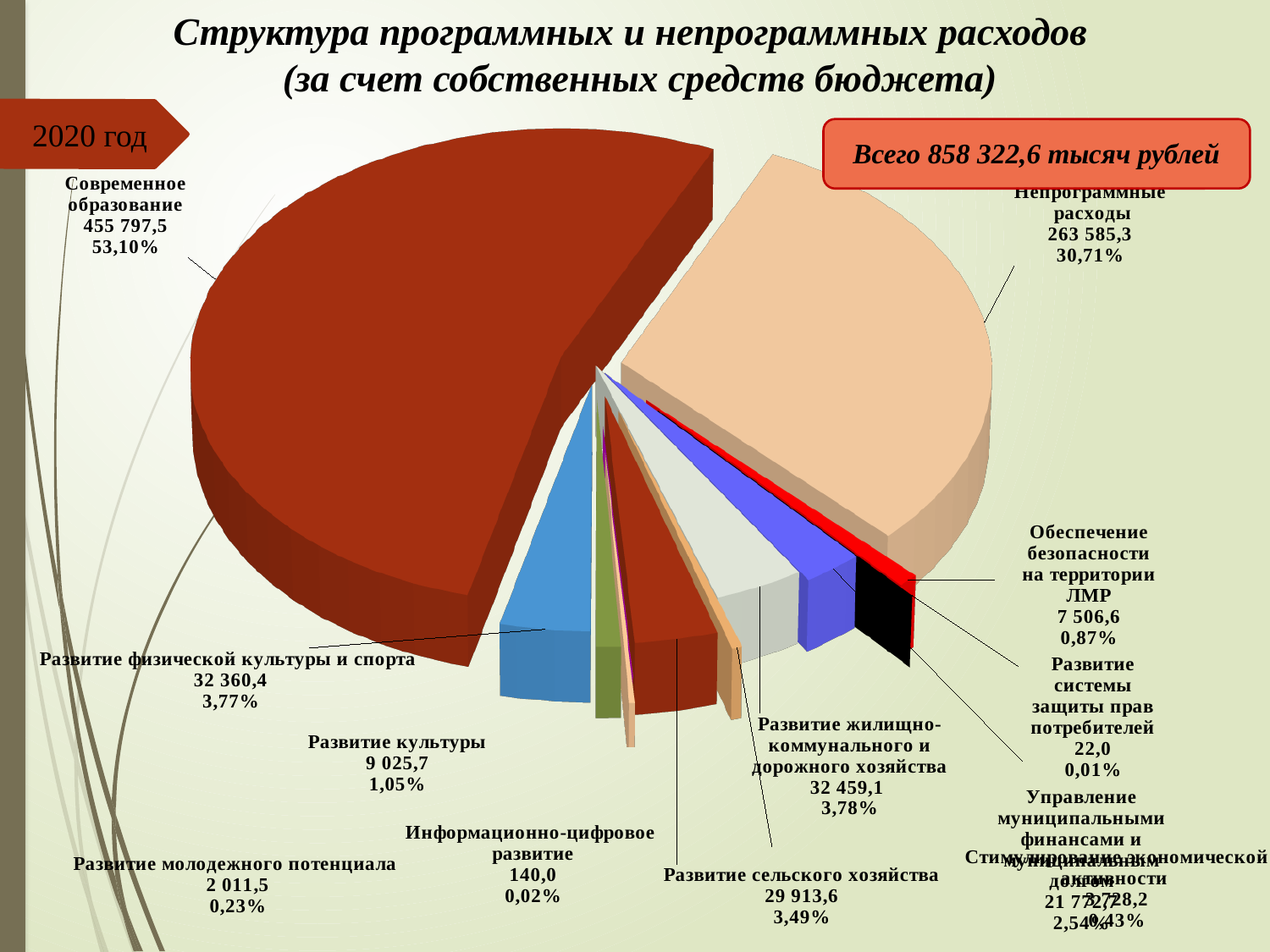
Which category has the largest slice of the pie? Современное образование What is the difference between the values for Современное образование and Непрограммные расходы? 192 212,2 What is the value for Современное образование? 455 797,5 What is the value for Развитие физической культуры и спорта? 32 360,4 Which category has the smallest slice of the pie? Развитие системы защиты прав потребителей What kind of chart is shown on the slide? pie chart Which year does the chart refer to? 2020 год What share of the pie does Непрограммные расходы take? 30,71% What share of the pie does Развитие культуры take? 1,05% What is the value for Информационно-цифровое развитие? 140,0 Which is larger, the value for Развитие сельского хозяйства or the value for Развитие культуры? Развитие сельского хозяйства What total amount is stated in the box on the slide? 858 322,6 тысяч рублей